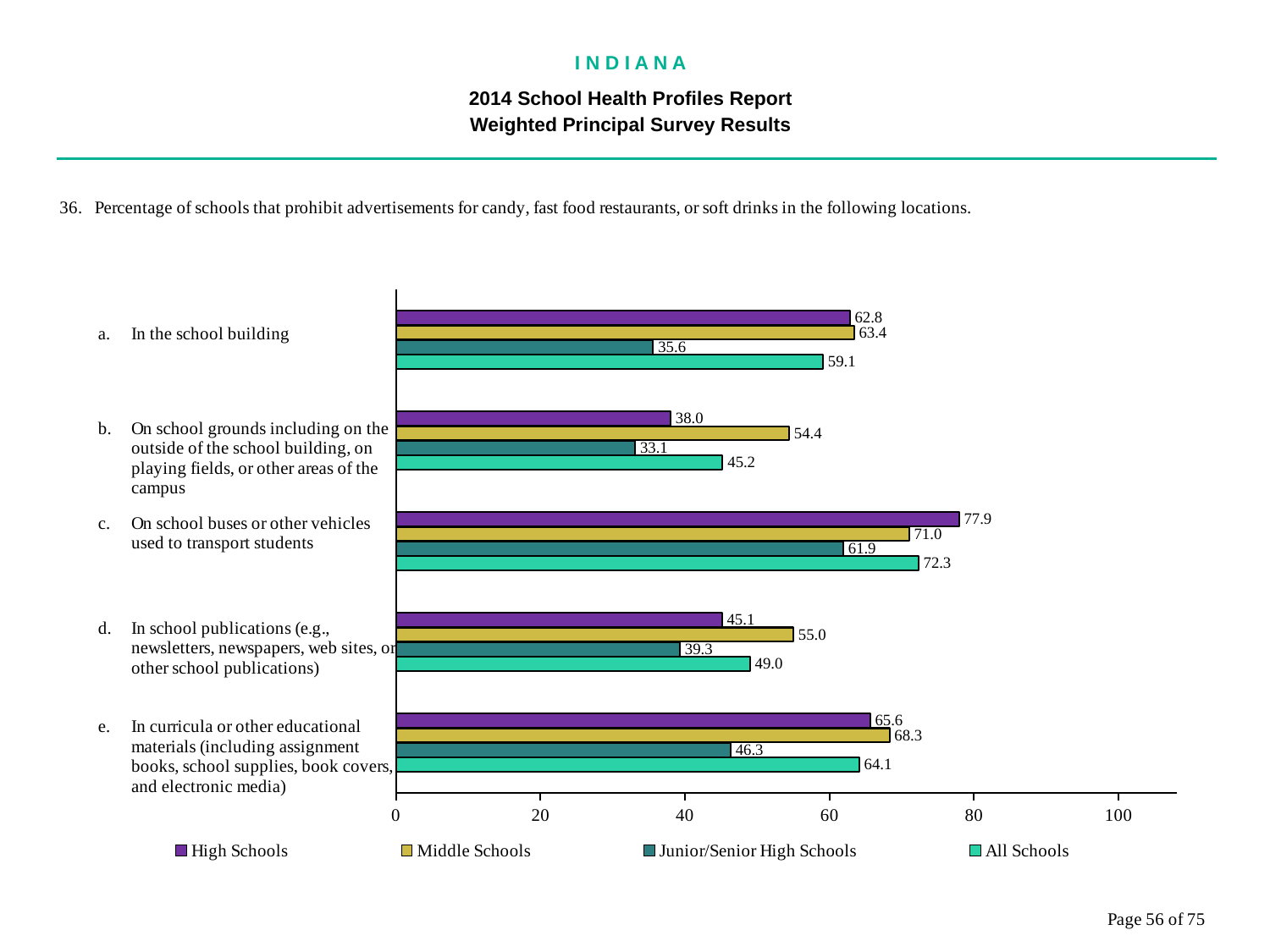
Is the All Schools value for 'On school buses or other vehicles used to transport students' greater or less than 60? greater How many locations (categories) are shown on the chart? 5 Which location has the lowest value for Junior/Senior High Schools? On school grounds including on the outside of the school building, on playing fields, or other areas of the campus What kind of chart is shown on the slide? Bar chart For 'In curricula or other educational materials', which is larger: the High Schools value or the Middle Schools value? Middle Schools What is the difference between the Middle Schools and High Schools values for 'On school grounds including on the outside of the school building, on playing fields, or other areas of the campus'? 16.4 How many series does the legend list? 4 Which location has the highest value for Middle Schools? On school buses or other vehicles used to transport students Which series is shown in purple in the legend? High Schools What is the value for Junior/Senior High Schools for 'In the school building'? 35.6 What is the value for High Schools for 'On school buses or other vehicles used to transport students'? 77.9 What is the value for All Schools for 'In school publications (e.g., newsletters, newspapers, web sites, or other school publications)'? 49.0